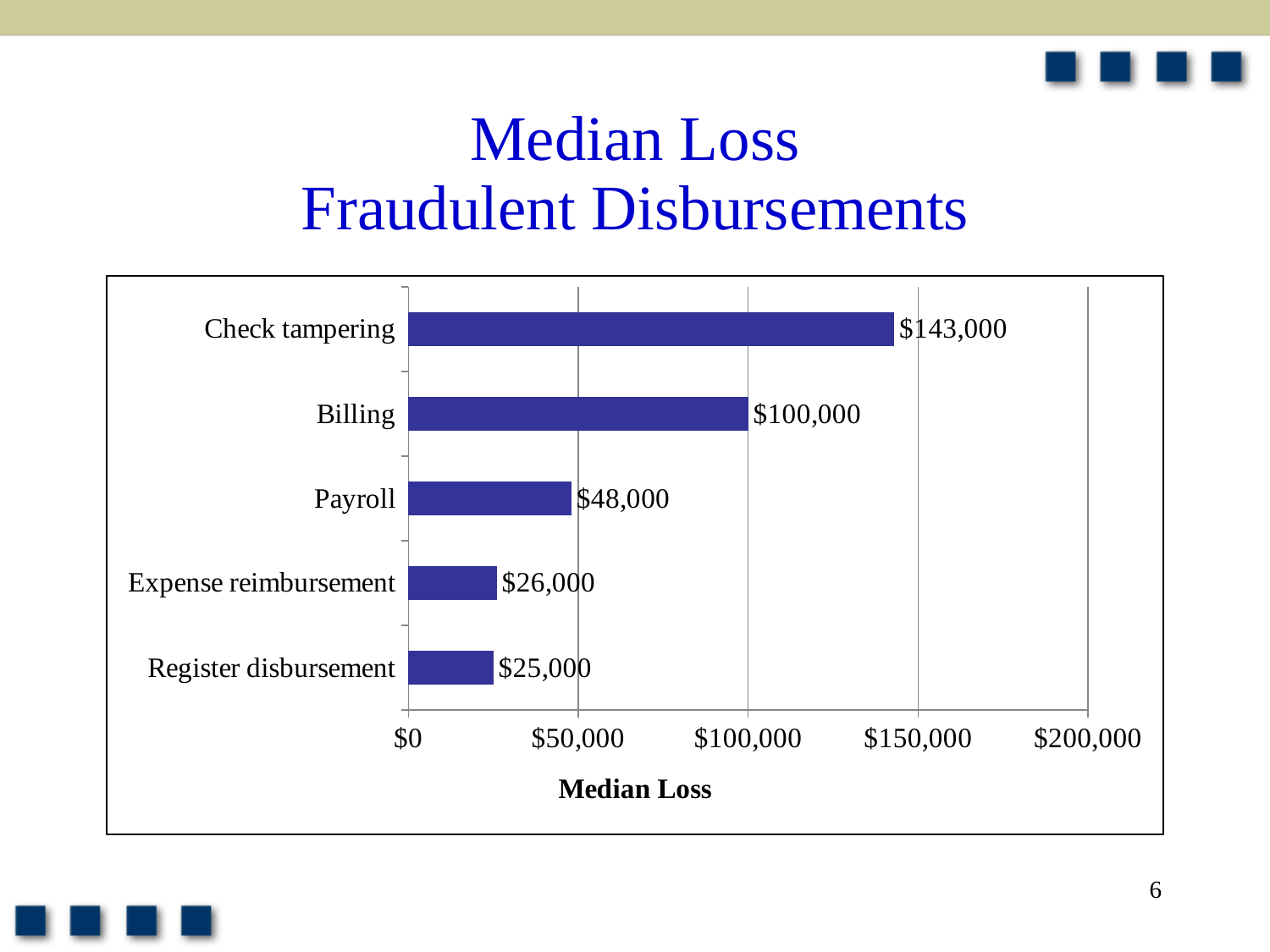
What kind of chart is shown on the slide? Bar chart Which has a larger median loss, Billing or Payroll? Billing What is the difference between the median loss for Check tampering and Billing? $43,000 What is the difference between the median loss for Payroll and Expense reimbursement? $22,000 What is the median loss for Payroll? $48,000 What is the label on the horizontal axis of the chart? Median Loss How many categories are shown in the chart? 5 What is the median loss for Check tampering? $143,000 Which category has the highest median loss? Check tampering Which category has the lowest median loss? Register disbursement What is the median loss for Expense reimbursement? $26,000 What is the median loss for Billing? $100,000